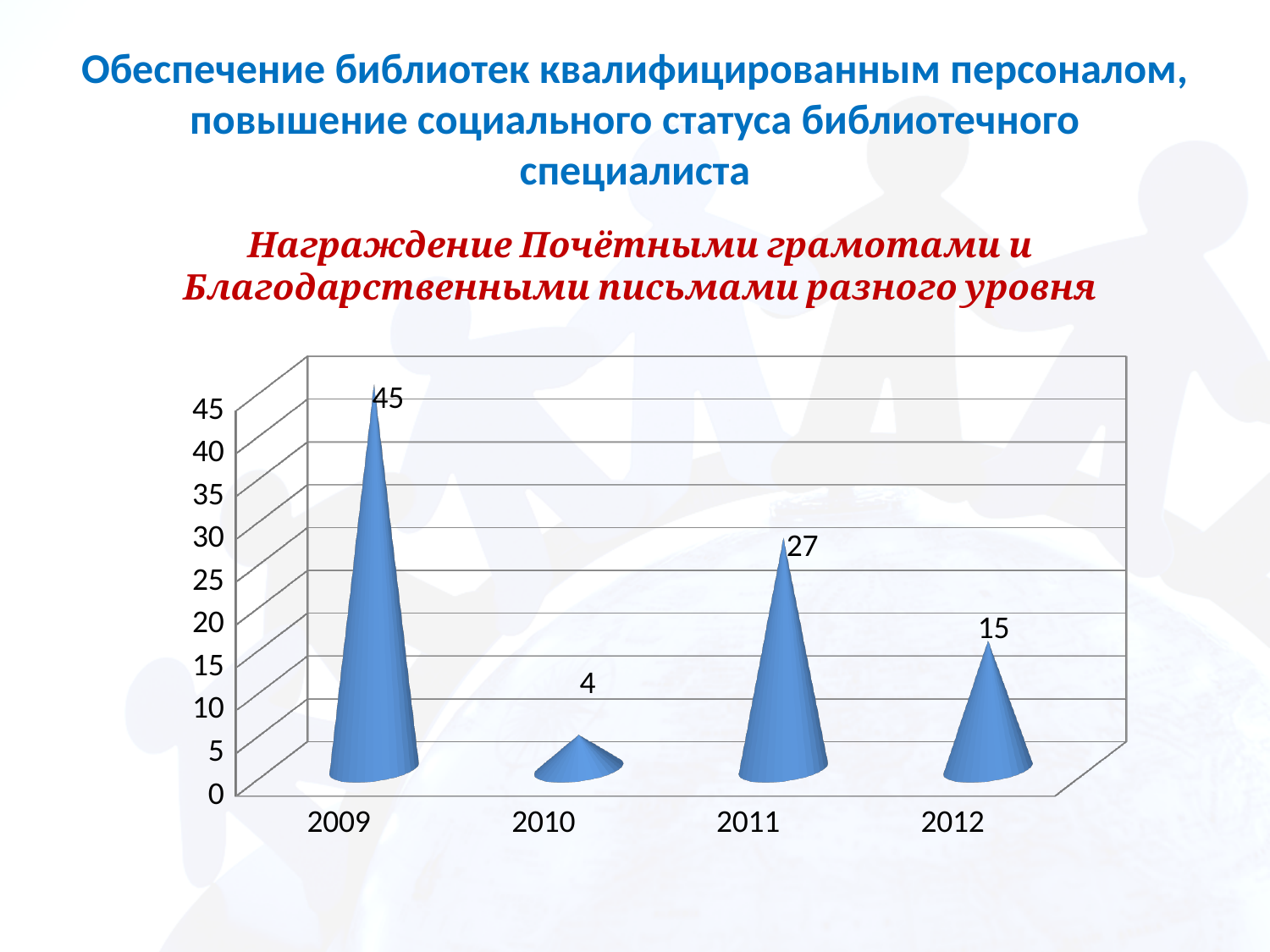
How many years are shown on the x axis? 4 What is the difference between the values for 2009 and 2011? 18 What is the value for 2009? 45 Which year has the lowest value? 2010 Which is larger, the value for 2011 or the value for 2012? 2011 What is the title of the chart? Награждение Почётными грамотами и Благодарственными письмами разного уровня Which year has the highest value? 2009 What is the difference between the values for 2011 and 2012? 12 What kind of chart is shown on the slide? bar chart What is the value for 2010? 4 What is the value for 2011? 27 What is the value for 2012? 15